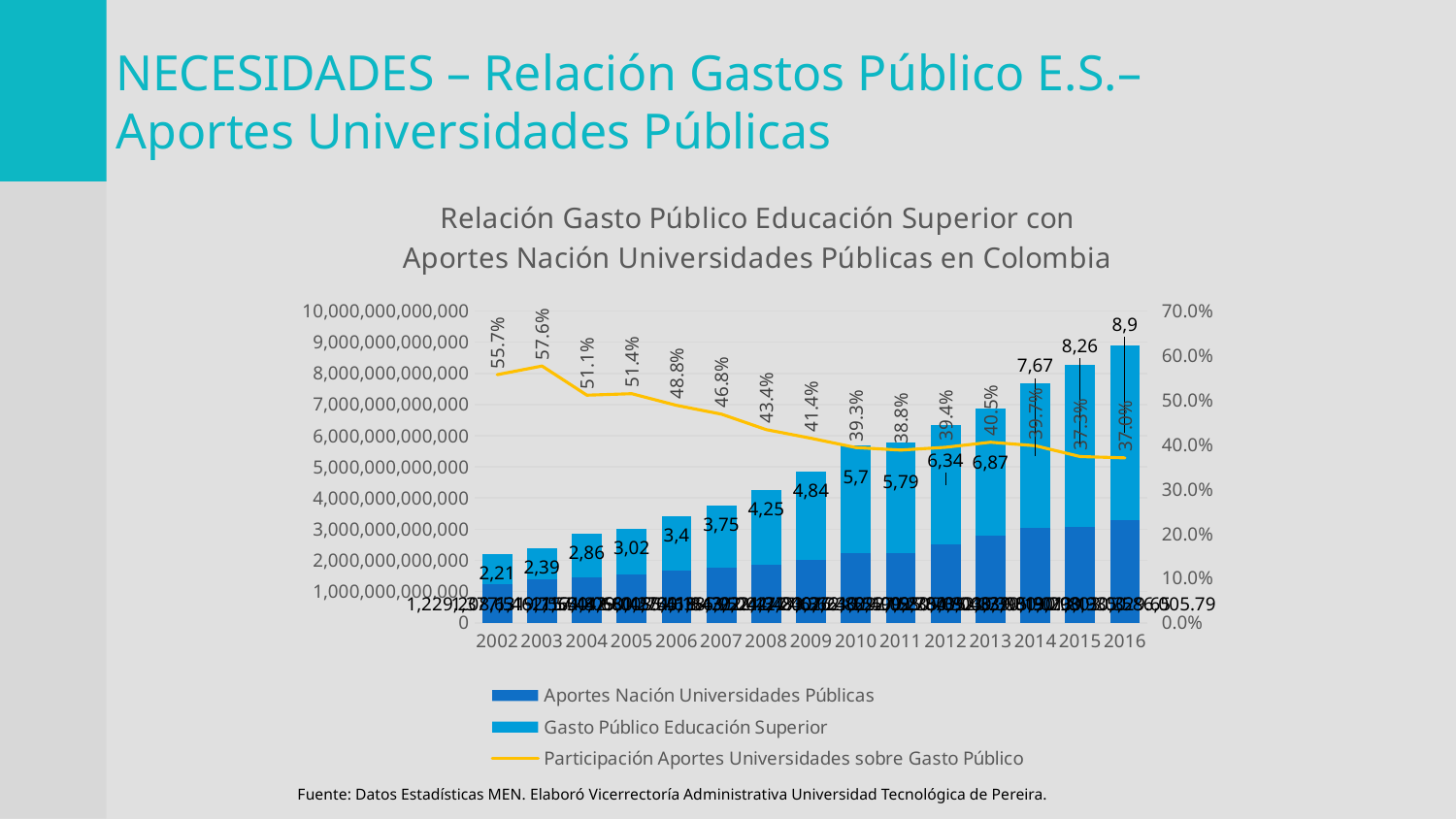
Does the Participación Aportes Universidades sobre Gasto Público line generally rise or fall from 2003 to 2016? Fall How many series does the legend list? 3 In which year is the Participación Aportes Universidades sobre Gasto Público line lowest? 2016 What is the data label for Gasto Público Educación Superior in 2002? 2,21 In which year is the Participación Aportes Universidades sobre Gasto Público line highest? 2003 What is the Participación Aportes Universidades sobre Gasto Público value for 2015? 37.3% What is the data label for Gasto Público Educación Superior in 2016? 8,9 What is the difference between the Participación values for 2003 (57.6%) and 2002 (55.7%)? 1.9% Which year has a larger Gasto Público Educación Superior label, 2010 or 2012? 2012 What is the Participación Aportes Universidades sobre Gasto Público value for 2003? 57.6% How many years are shown on the x axis? 15 What kind of chart is this? Stacked bar chart with a line